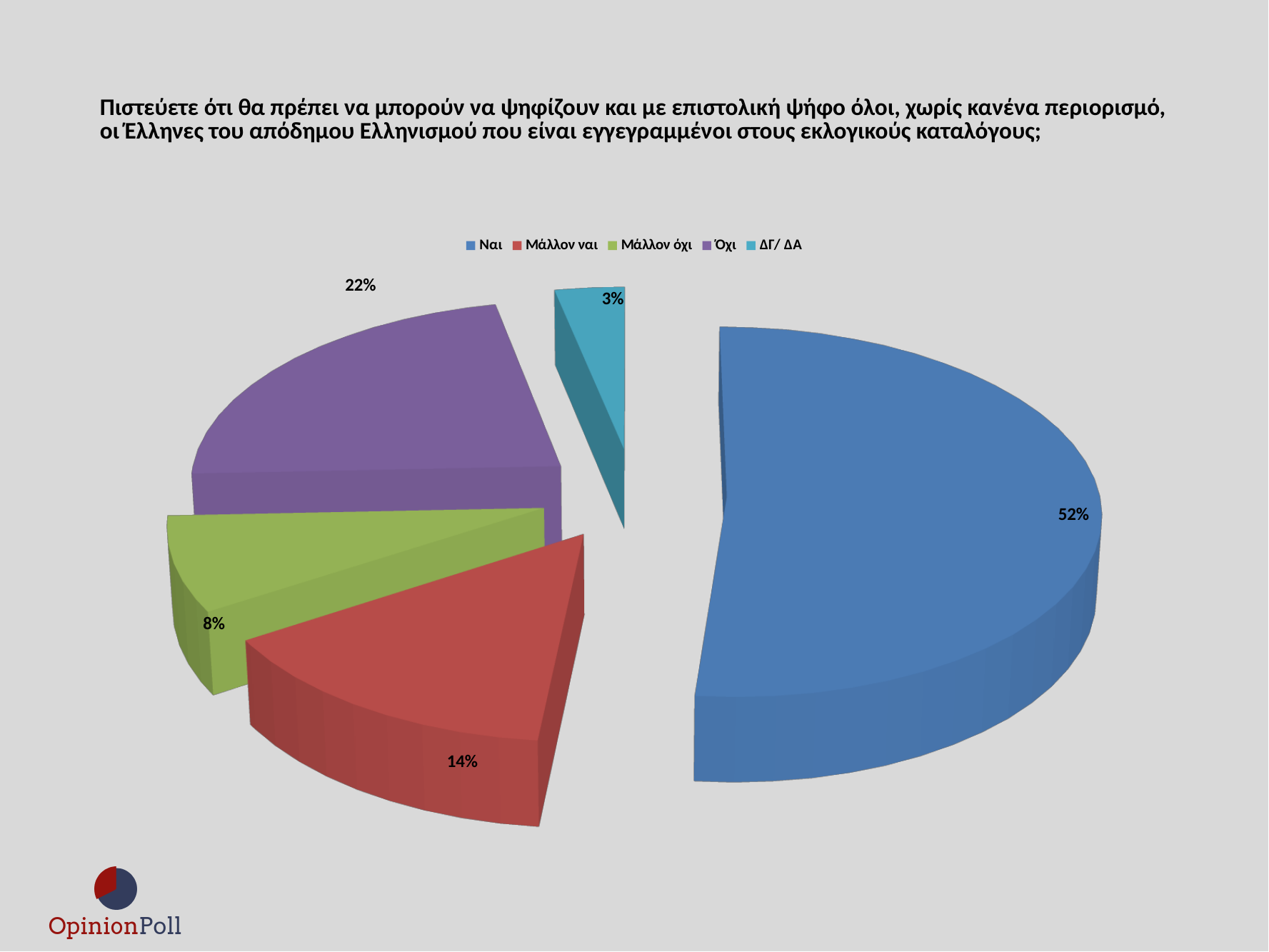
Which response has the largest share of the pie? Ναι What percentage of respondents answered "Μάλλον όχι"? 8% What percentage of respondents answered "Ναι"? 52% Which is larger, the share for "Μάλλον ναι" or the share for "Μάλλον όχι"? Μάλλον ναι What kind of chart is shown on the slide? Pie chart Which response has the smallest share of the pie? ΔΓ/ ΔΑ What is the difference in percentage points between "Ναι" and "Όχι"? 30 What percentage of respondents answered "Όχι"? 22% What percentage of respondents answered "ΔΓ/ ΔΑ"? 3% What percentage of respondents answered "Μάλλον ναι"? 14% How many slices does the pie chart have? 5 What colour is the slice for "Όχι"? Purple